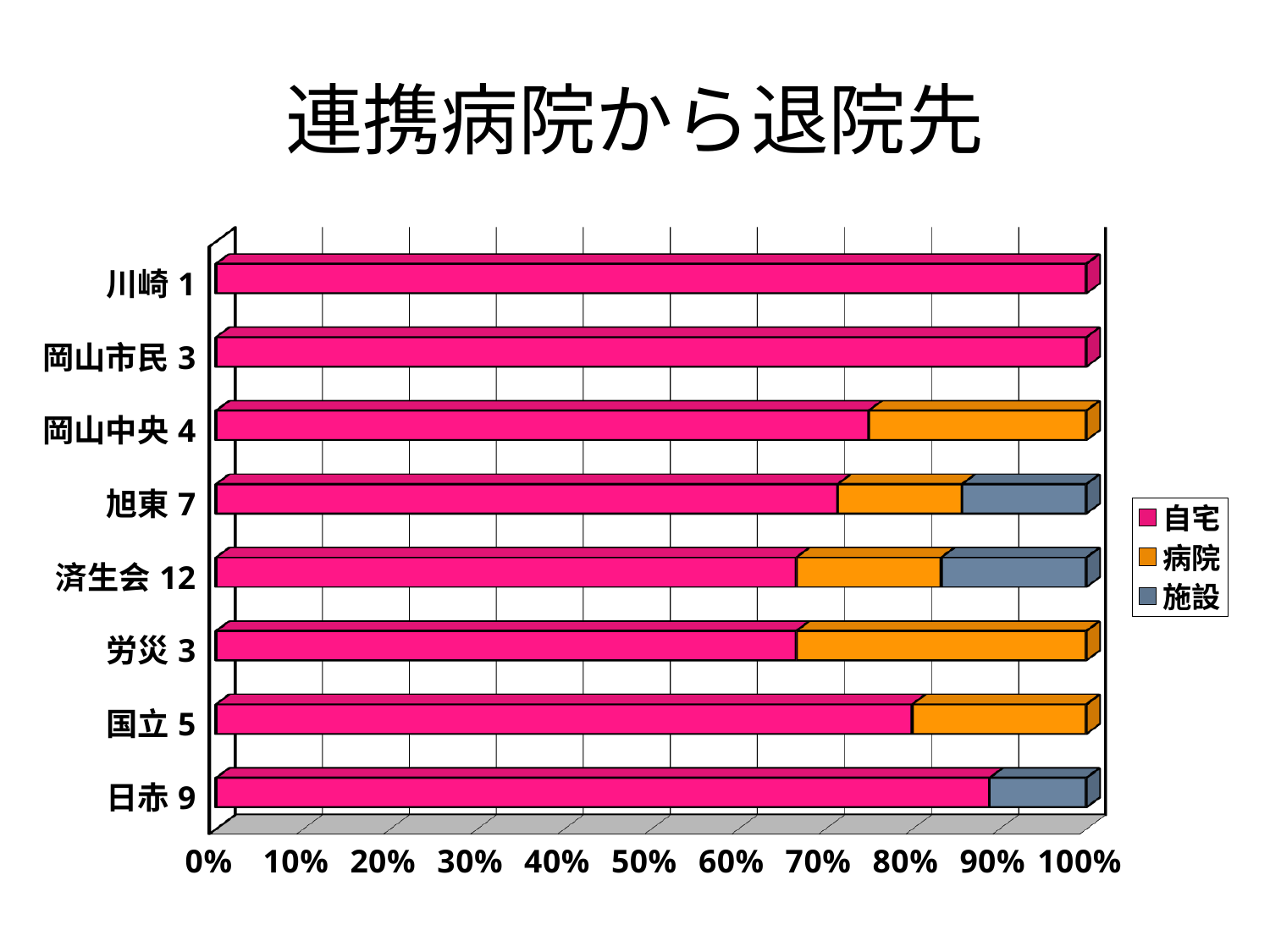
Which series is shown in pink in the legend? 自宅 What is the 自宅 share for 国立 5? 80% How many hospital categories are plotted on the chart? 8 What is the 自宅 share for 川崎 1? 100% How many hospital categories include a 施設 segment? 3 Which has the larger 自宅 share, 岡山中央 4 or 労災 3? 岡山中央 4 What kind of chart is shown on the slide? stacked bar chart Is the 自宅 share for 岡山中央 4 greater or less than 70%? greater Is the 自宅 share for 済生会 12 greater or less than 70%? less How many series does the legend list? 3 What is the title of the chart? 連携病院から退院先